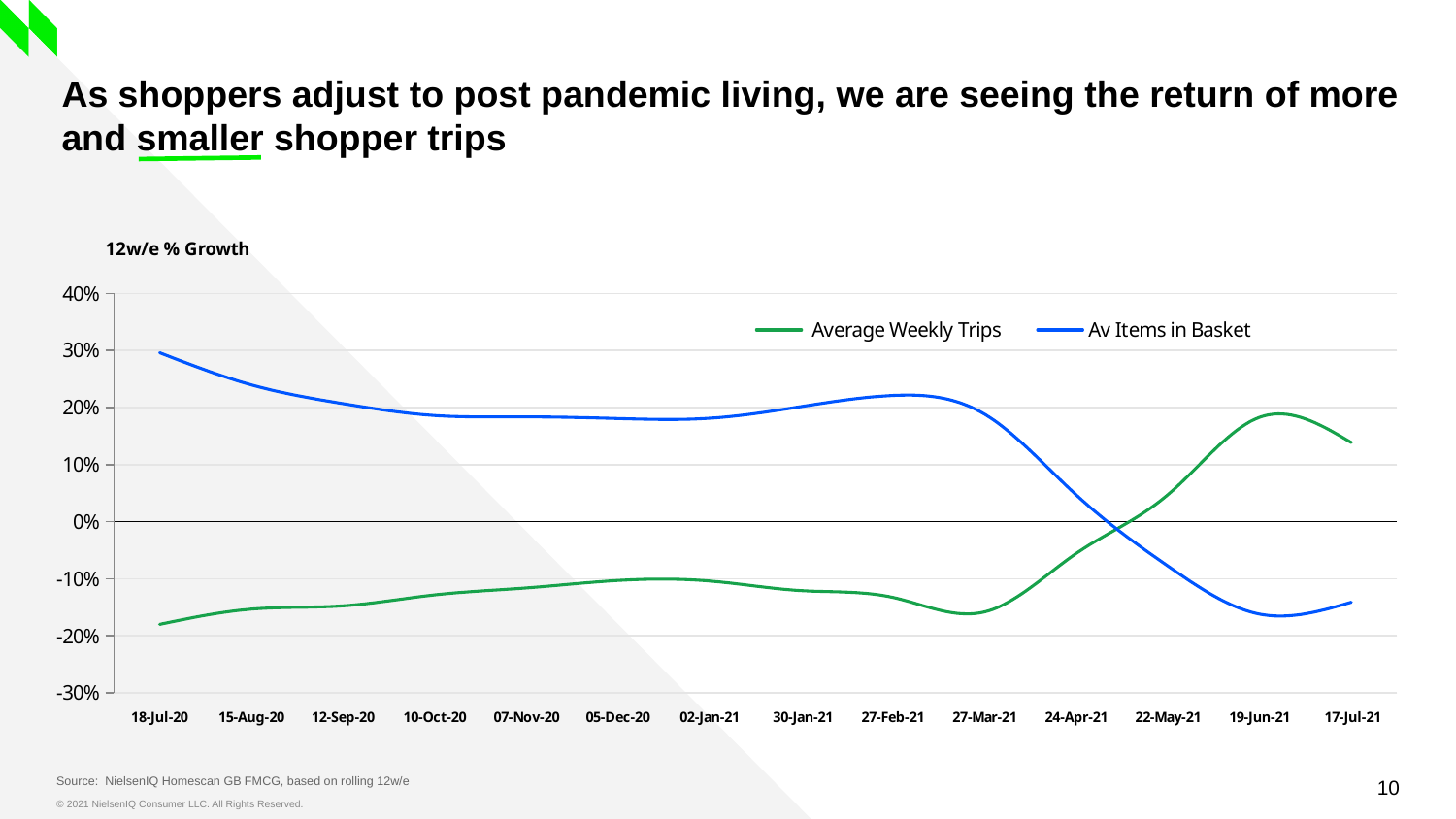
Does the Av Items in Basket line rise or fall overall from 18-Jul-20 to 17-Jul-21? Fall What kind of chart is shown on the slide? Line chart Is the value for Av Items in Basket at 18-Jul-20 greater or less than 20%? greater What is the title shown above the chart? 12w/e % Growth How many series does the legend list? 2 Is the value for Average Weekly Trips at 19-Jun-21 greater or less than 10%? greater Is the value for Average Weekly Trips at 02-Jan-21 greater or less than 0%? less At 18-Jul-20, which series has the higher value, Average Weekly Trips or Av Items in Basket? Av Items in Basket At 17-Jul-21, which series has the higher value, Average Weekly Trips or Av Items in Basket? Average Weekly Trips How many dates are labelled along the x axis? 14